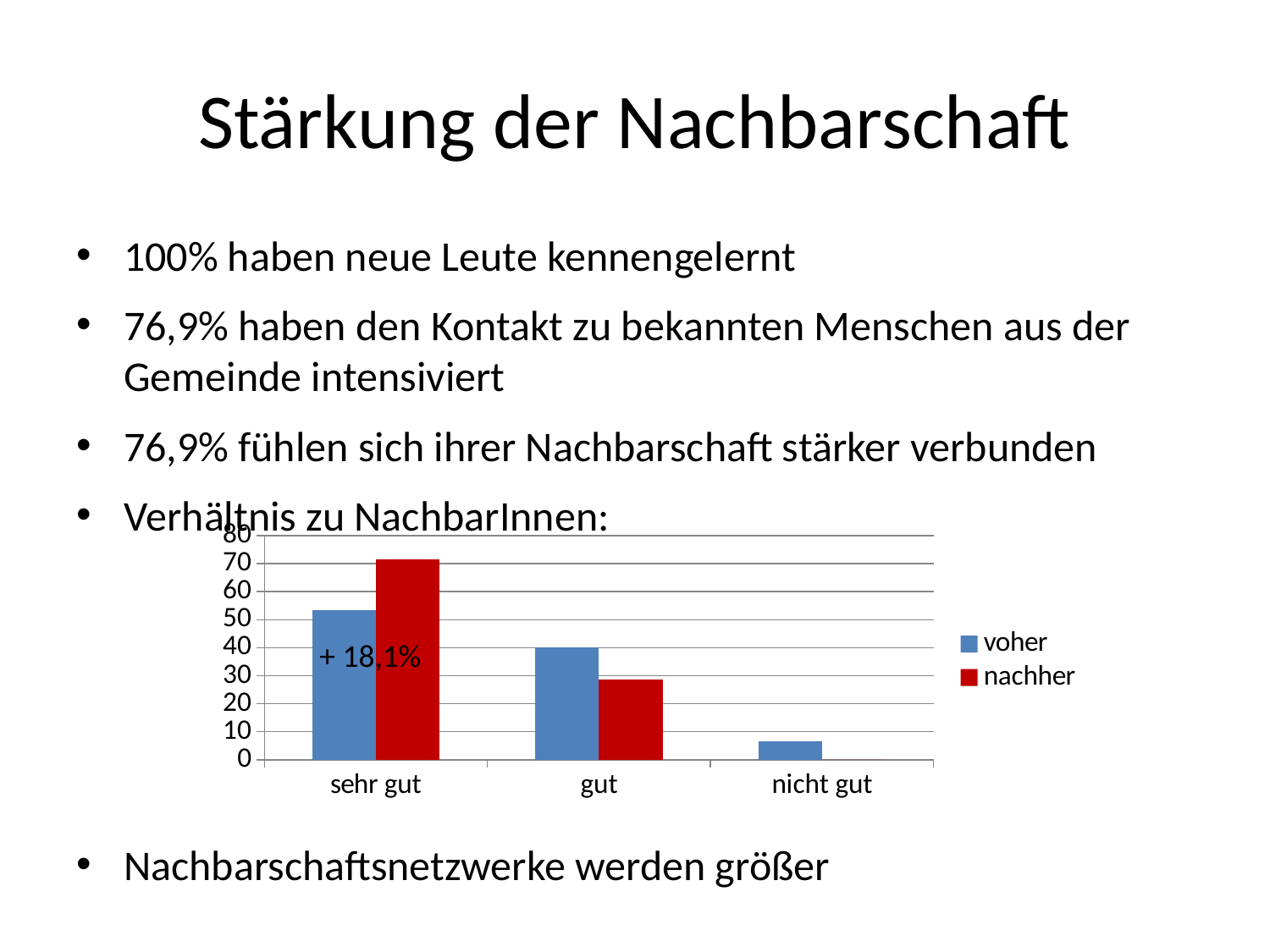
Is the 'nachher' value for 'sehr gut' greater or less than 60? greater What are the two series named in the chart's legend? voher, nachher How many categories are shown on the x axis of the chart? 3 What annotation is printed on the chart next to the 'sehr gut' bars? + 18,1% What kind of chart is shown on the slide? bar chart Is the 'nachher' value for 'gut' greater or less than 40? less For 'gut', which series has the larger value, 'voher' or 'nachher'? voher Which category has the lowest 'voher' value? nicht gut Is the 'voher' value for 'nicht gut' greater or less than 10? less For 'sehr gut', which series has the larger value, 'voher' or 'nachher'? nachher Which category has the tallest bar in the chart? sehr gut How many series does the chart's legend list? 2